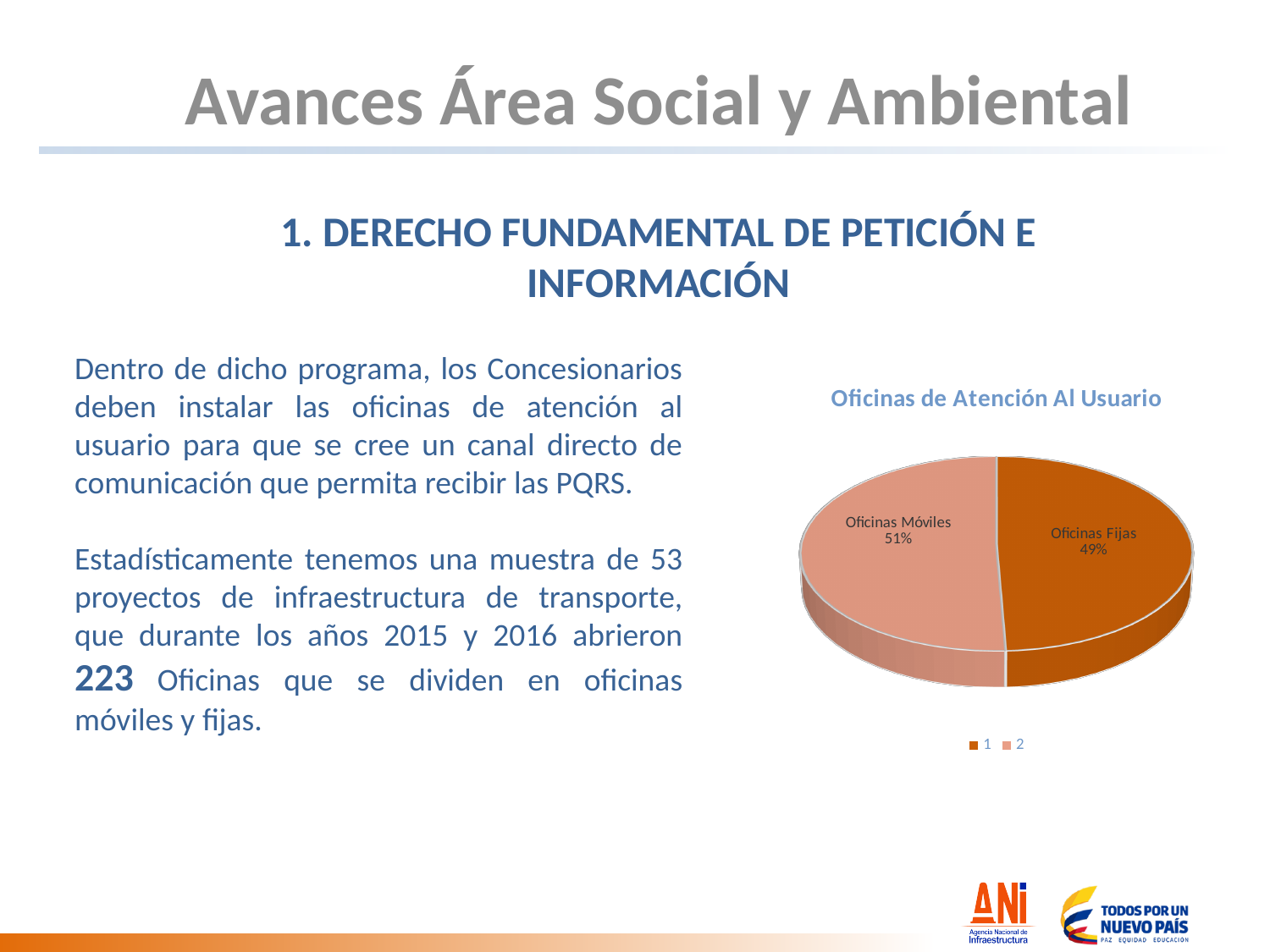
What is the difference in percentage points between Oficinas Móviles and Oficinas Fijas? 2 percentage points Is the share for Oficinas Fijas greater or less than 50%? less What share of the pie is Oficinas Fijas? 49% Which slice is the largest in the pie chart? Oficinas Móviles Which is larger, the share for Oficinas Móviles or the share for Oficinas Fijas? Oficinas Móviles Which slice is the smallest in the pie chart? Oficinas Fijas What is the title of the chart? Oficinas de Atención Al Usuario What type of chart is shown on the slide? Pie chart How many entries does the legend list? 2 How many slices does the pie chart have? 2 What share of the pie is Oficinas Móviles? 51%